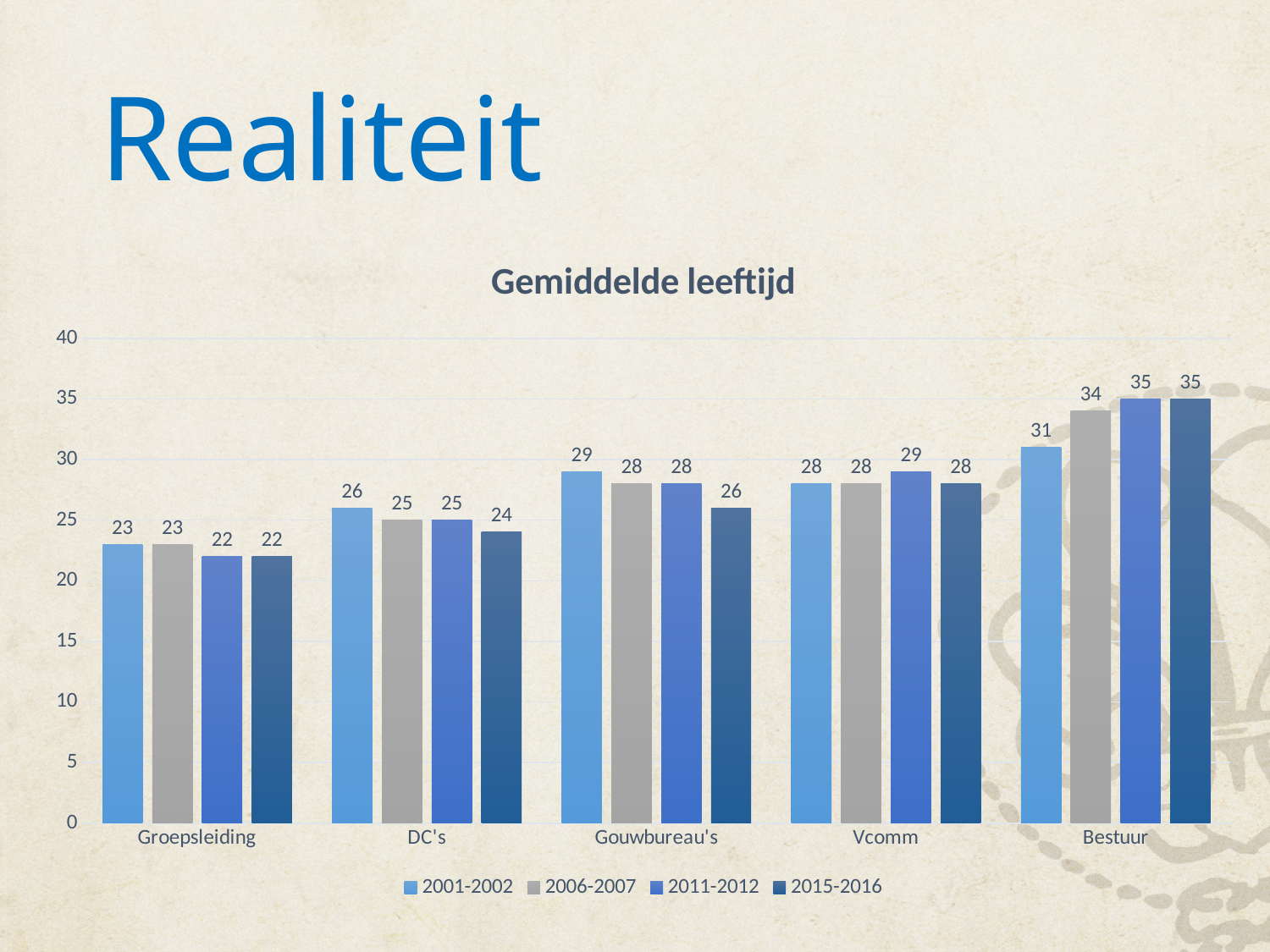
What is the value for Bestuur in the 2006-2007 series? 34 Which category has the lowest value in the 2001-2002 series? Groepsleiding How many series does the legend list? 4 How many categories are shown on the x axis? 5 What kind of chart is shown on the slide? bar chart What is the value for DC's in the 2015-2016 series? 24 Does the 2015-2016 value rise or fall from Groepsleiding to Bestuur? rise What is the difference between the 2001-2002 value and the 2015-2016 value for Bestuur? 4 Which category has the highest value in the 2015-2016 series? Bestuur Which is larger: the 2001-2002 value for DC's or the 2001-2002 value for Vcomm? Vcomm What is the title of the chart? Gemiddelde leeftijd What is the value for Gouwbureau's in the 2001-2002 series? 29